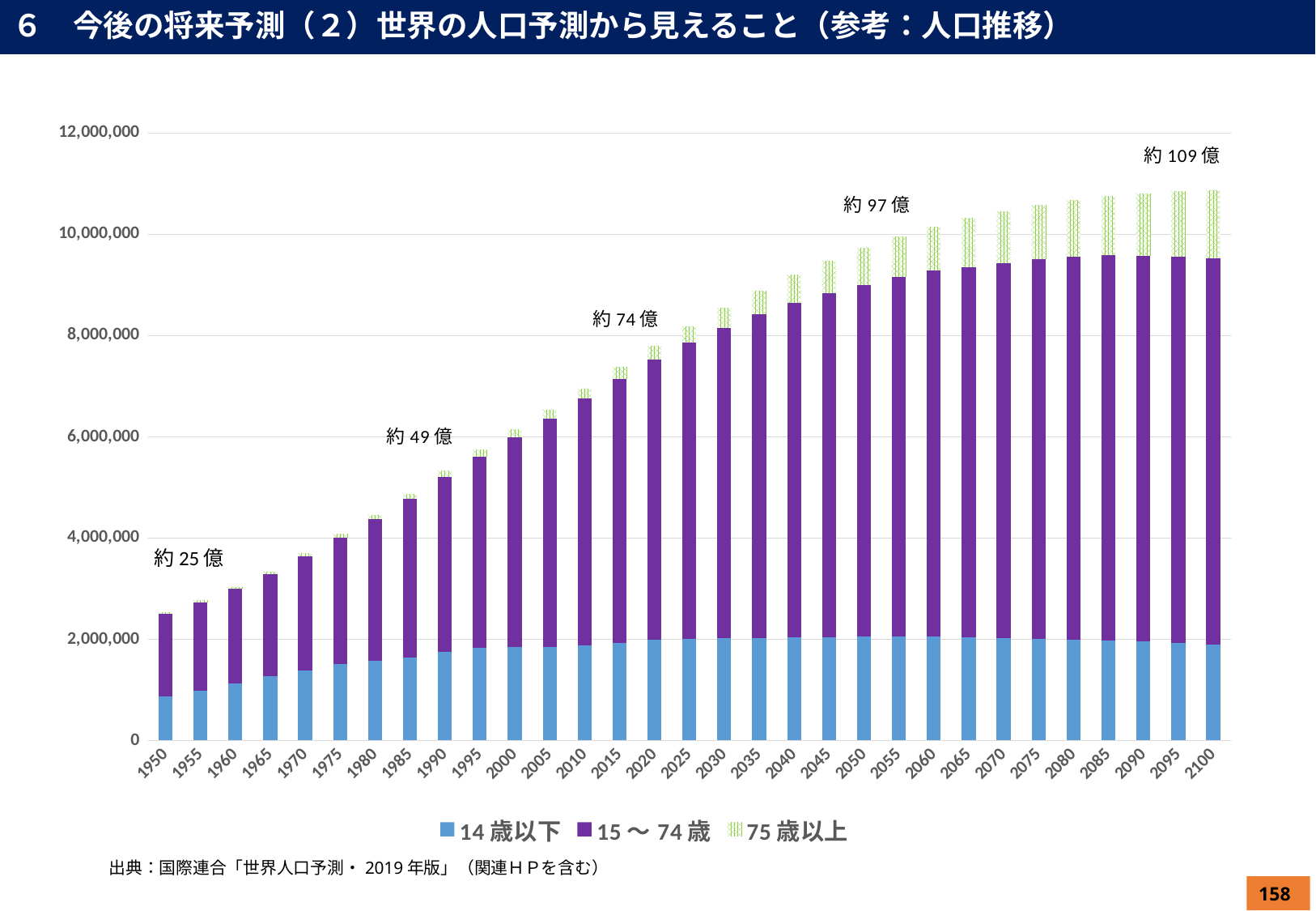
Is the total bar for 1980 greater or less than 4,000,000? greater What annotation is printed above the 2100 bar? 約109億 Do the total bar heights generally rise or fall from 1950 to 2100? rise What kind of chart is shown on the slide? stacked bar chart Which year has the tallest total bar? 2100 Is the total bar for 1950 greater or less than 4,000,000? less What are the three legend entries of the chart? 14歳以下, 15〜74歳, 75歳以上 Is the total bar for 2100 greater or less than 10,000,000? greater How many years (bars) are plotted along the x axis? 31 Which year has the shortest total bar? 1950 In 2020, which series has the larger segment: 14歳以下 or 15〜74歳? 15〜74歳 How many series does the legend list? 3